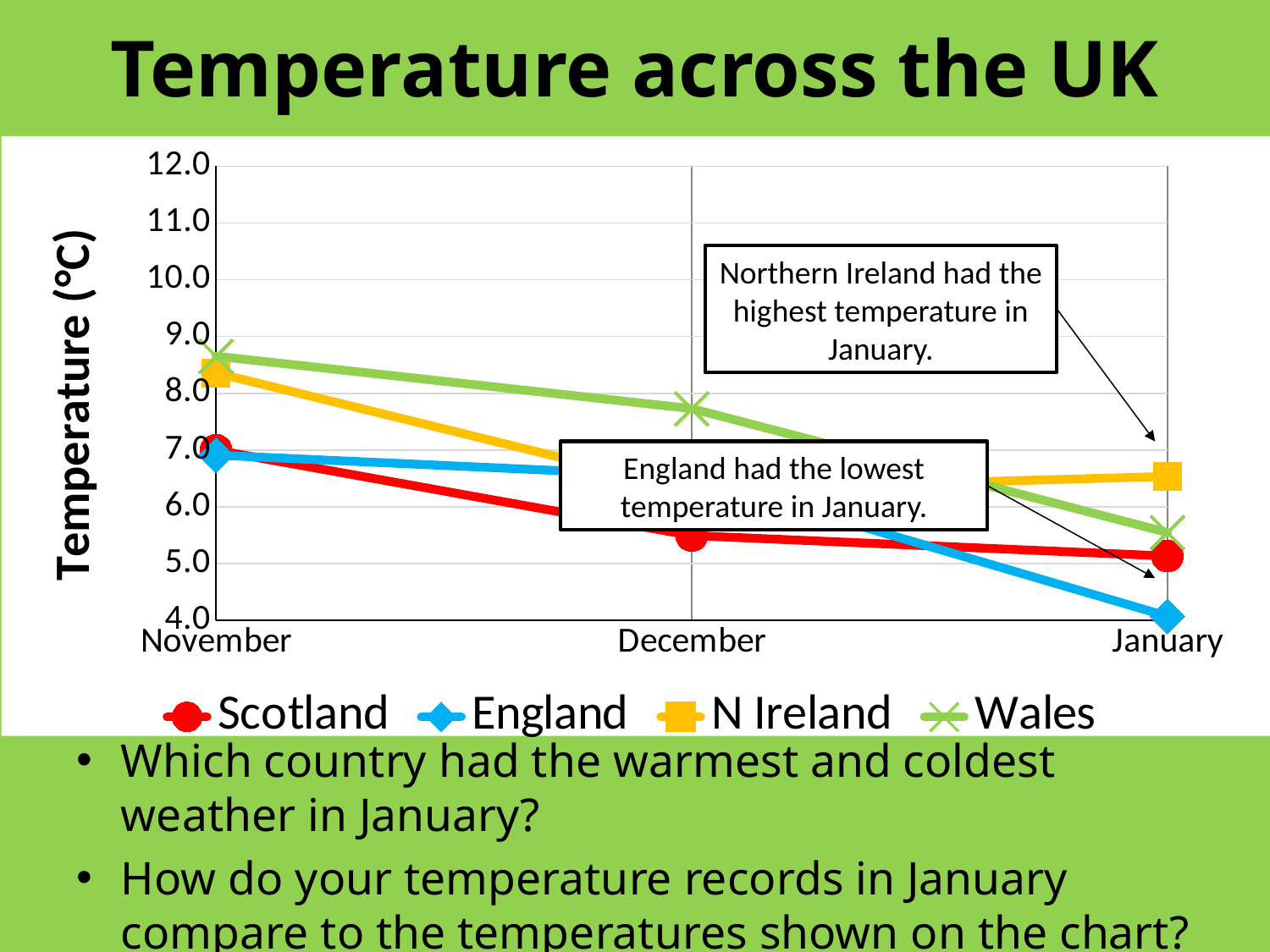
How many series does the legend list? 4 What is the label on the y axis? Temperature (°C) Is the temperature for England in January greater or less than 5.0? less How many months are shown along the x axis? 3 Is the temperature for Wales in December greater or less than 7.0? greater Is the temperature for Scotland in December greater or less than 6.0? less Does the temperature for Scotland rise or fall from November to January? fall In December, which had the higher temperature, Wales or Scotland? Wales Which country had the highest temperature in January? N Ireland What kind of chart is shown on the slide? Line chart Which country had the lowest temperature in January? England